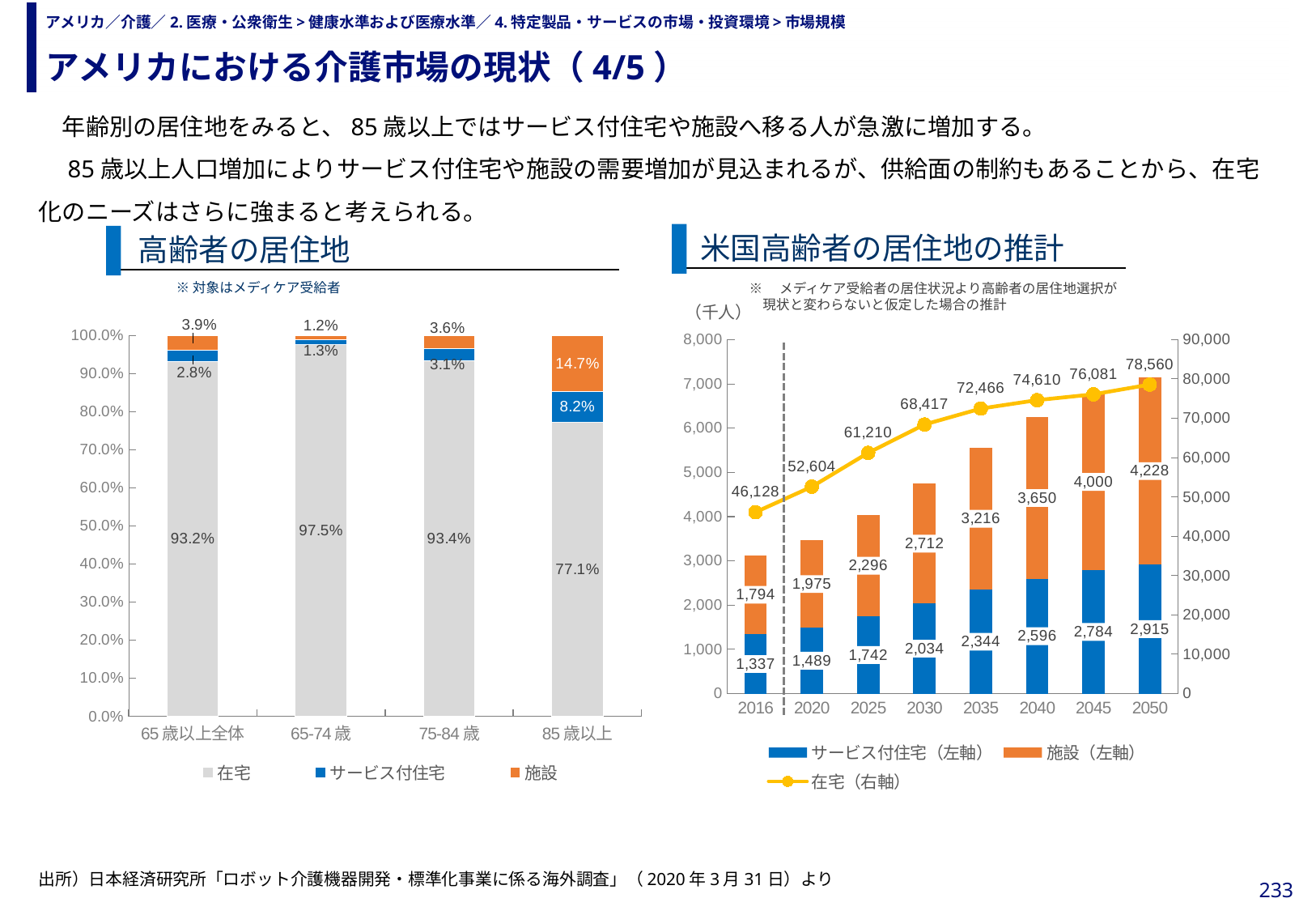
In the chart titled 高齢者の居住地, how many series does the legend list? 3 In the chart titled 米国高齢者の居住地の推計, what is the value for 施設 in 2050? 4,228 In the chart titled 高齢者の居住地, what is the 施設 share for 85歳以上? 14.7% In the chart titled 高齢者の居住地, which age category has the highest 在宅 share? 65-74歳 In the chart titled 米国高齢者の居住地の推計, what is the difference between the 在宅 values for 2050 and 2045? 2,479 In the chart titled 高齢者の居住地, what is the difference between the サービス付住宅 share for 85歳以上 and for 75-84歳? 5.1% In the chart titled 米国高齢者の居住地の推計, which series is plotted on the right axis according to the legend? 在宅（右軸） In the chart titled 米国高齢者の居住地の推計, what is the total of the stacked bar for 2030 (サービス付住宅 plus 施設)? 4,746 In the chart titled 米国高齢者の居住地の推計, does the 在宅 line rise or fall from 2016 to 2050? rise In the chart titled 米国高齢者の居住地の推計, how many years are shown on the x axis? 8 In the chart titled 高齢者の居住地, what is the 在宅 share for 85歳以上? 77.1% In the chart titled 米国高齢者の居住地の推計, what is the value for 在宅 in 2016? 46,128